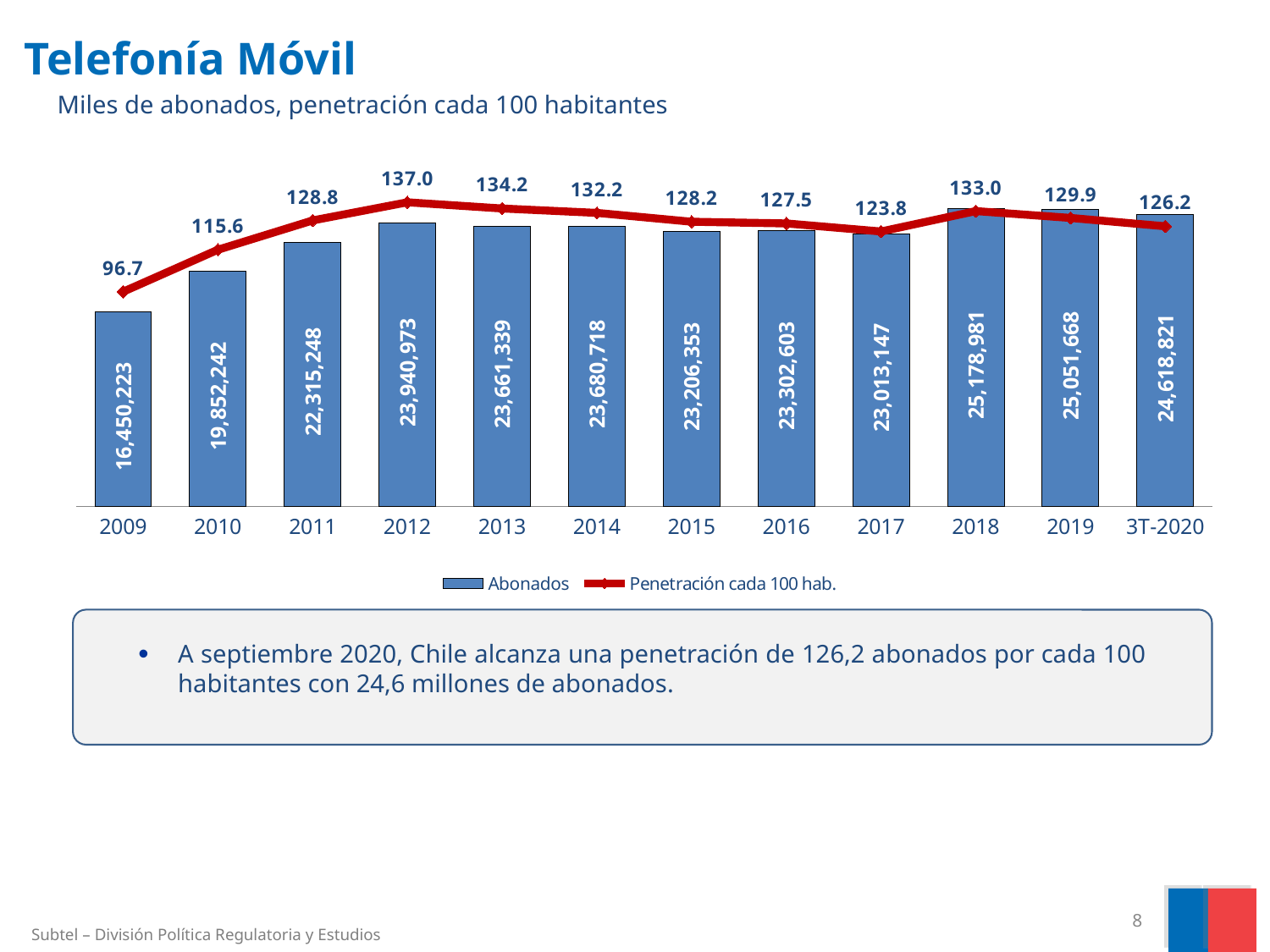
What is the value of Abonados for 2012? 23,940,973 What is the Penetración cada 100 hab. value for 2017? 123.8 Which is larger, the Abonados value for 2013 or for 2014? 2014 What is the difference in Abonados between 2018 and 2019? 127,313 How many series does the legend list? 2 Which year has the lowest Penetración cada 100 hab. value? 2009 Which year has the highest Penetración cada 100 hab. value? 2012 How many periods are shown on the x axis? 12 By how much did Penetración cada 100 hab. fall from 2012 to 3T-2020? 10.8 Does Penetración cada 100 hab. rise or fall from 2012 to 2017? fall Which year has the highest Abonados value? 2018 What is the Abonados value for 3T-2020? 24,618,821